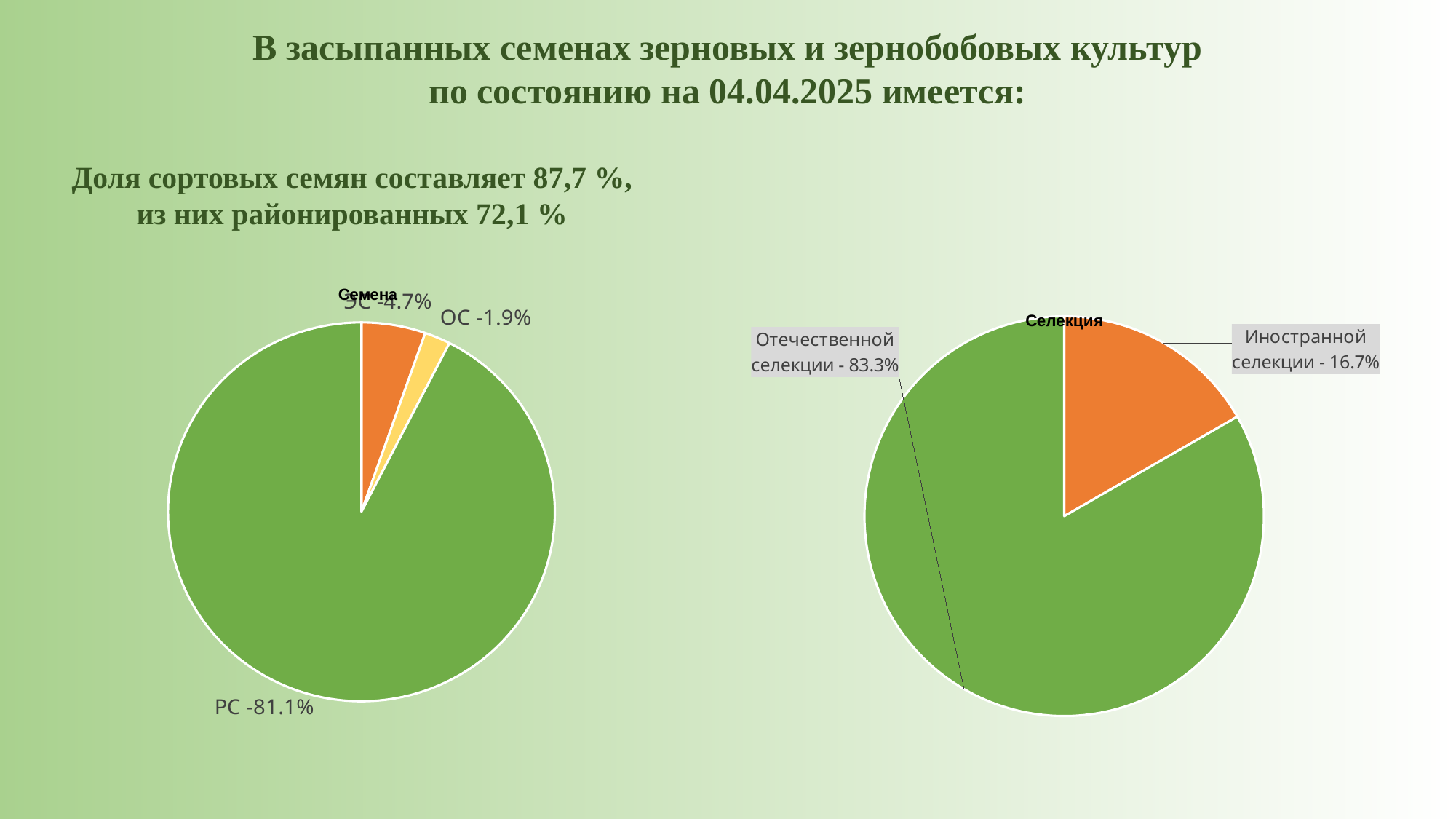
In the "Семена" pie chart, which slice is the smallest? ОС In the "Семена" pie chart, how many slices are there? 3 In the "Семена" pie chart, what share is shown for ЭС? 4.7% In the "Селекция" pie chart, what colour is the Иностранной селекции slice? orange In the "Селекция" pie chart, which is larger: Отечественной селекции or Иностранной селекции? Отечественной селекции What kind of chart is the left chart titled "Семена"? pie chart In the "Селекция" pie chart, what share is shown for Иностранной селекции? 16.7% In the "Семена" pie chart, which slice is the largest? РС In the "Селекция" pie chart, what share is shown for Отечественной селекции? 83.3% In the "Семена" pie chart, what share is shown for РС? 81.1% In the "Семена" pie chart, what share is shown for ОС? 1.9% In the "Семена" pie chart, what is the difference between the ЭС and ОС shares? 2.8%